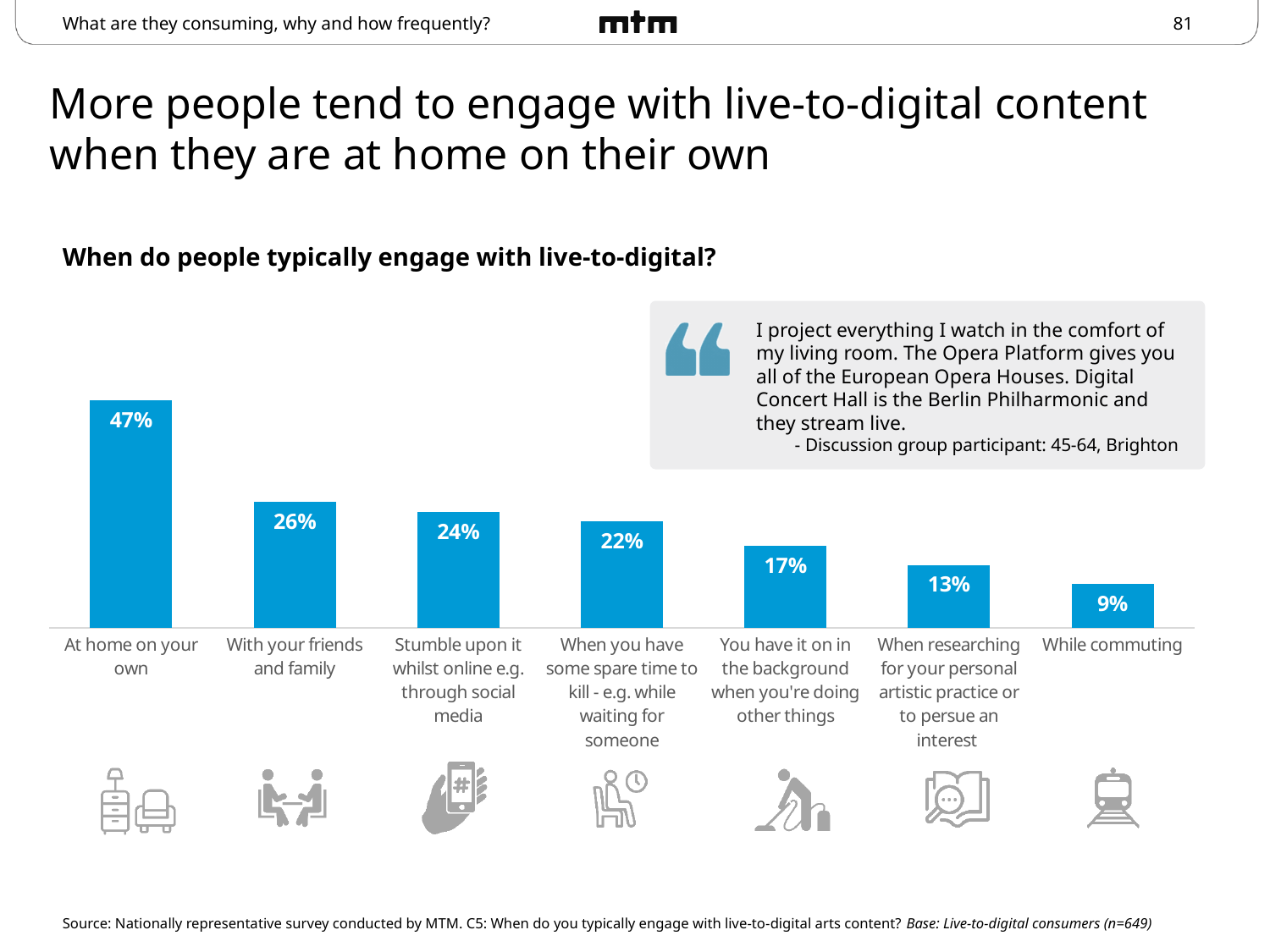
How many categories are shown in the chart? 7 Which category has the highest value? At home on your own What is the title of the chart? When do people typically engage with live-to-digital? What percentage of people engage with live-to-digital content when researching for their personal artistic practice or to pursue an interest? 13% Which category has the lowest value? While commuting Which is larger: 'Stumble upon it whilst online e.g. through social media' or 'When you have some spare time to kill - e.g. while waiting for someone'? Stumble upon it whilst online e.g. through social media What is the difference between 'At home on your own' and 'With your friends and family'? 21 percentage points What type of chart is shown on the slide? Bar chart What is the value for 'While commuting'? 9% What percentage of people engage with live-to-digital content at home on their own? 47% Do the values rise or fall from left to right across the chart? Fall What is the value for 'You have it on in the background when you're doing other things'? 17%